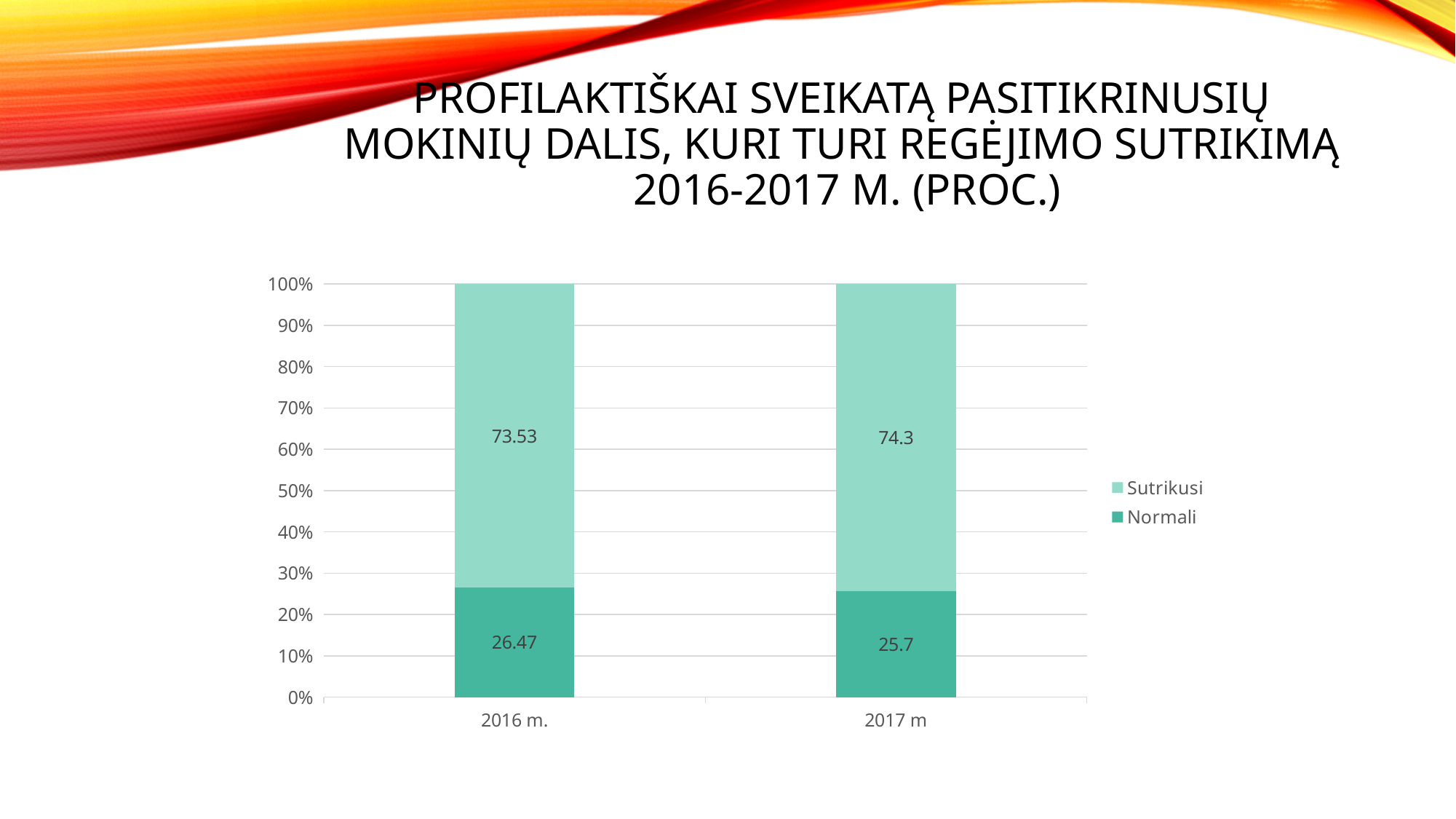
What is the value for Sutrikusi in 2016 m.? 73.53 How many categories are shown on the x axis? 2 What is the value for Sutrikusi in 2017 m? 74.3 What kind of chart is shown on the slide? Stacked bar chart Which series is shown in the darker green colour? Normali How many series does the legend list? 2 What is the difference between the Normali values for 2016 m. and 2017 m? 0.77 What is the value for Normali in 2017 m? 25.7 Is the Sutrikusi value larger in 2016 m. or in 2017 m? 2017 m Which year has the lower Normali value? 2017 m Which year has the higher Sutrikusi value? 2017 m What is the value for Normali in 2016 m.? 26.47